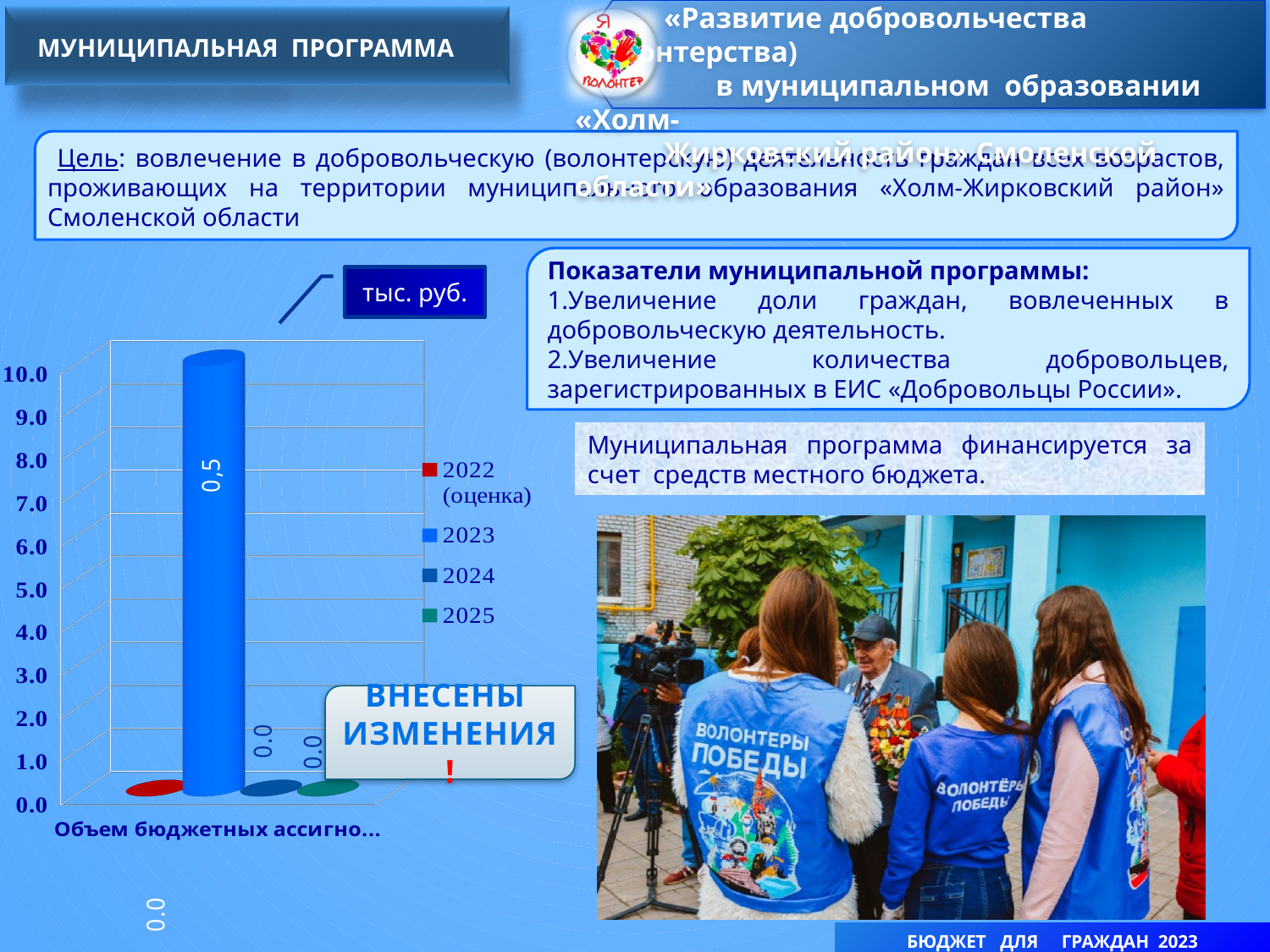
How many series does the chart legend list? 4 What is the first entry in the chart legend? 2022 (оценка) What kind of chart is shown on the slide? bar chart Which is larger, the value for 2023 or the value for 2024? 2023 What is the value for 2024 in the chart? 0.0 Which year has the highest value in the chart? 2023 What is the value for 2025 in the chart? 0.0 What unit is indicated in the box above the chart? тыс. руб. How many bars are plotted in the chart? 4